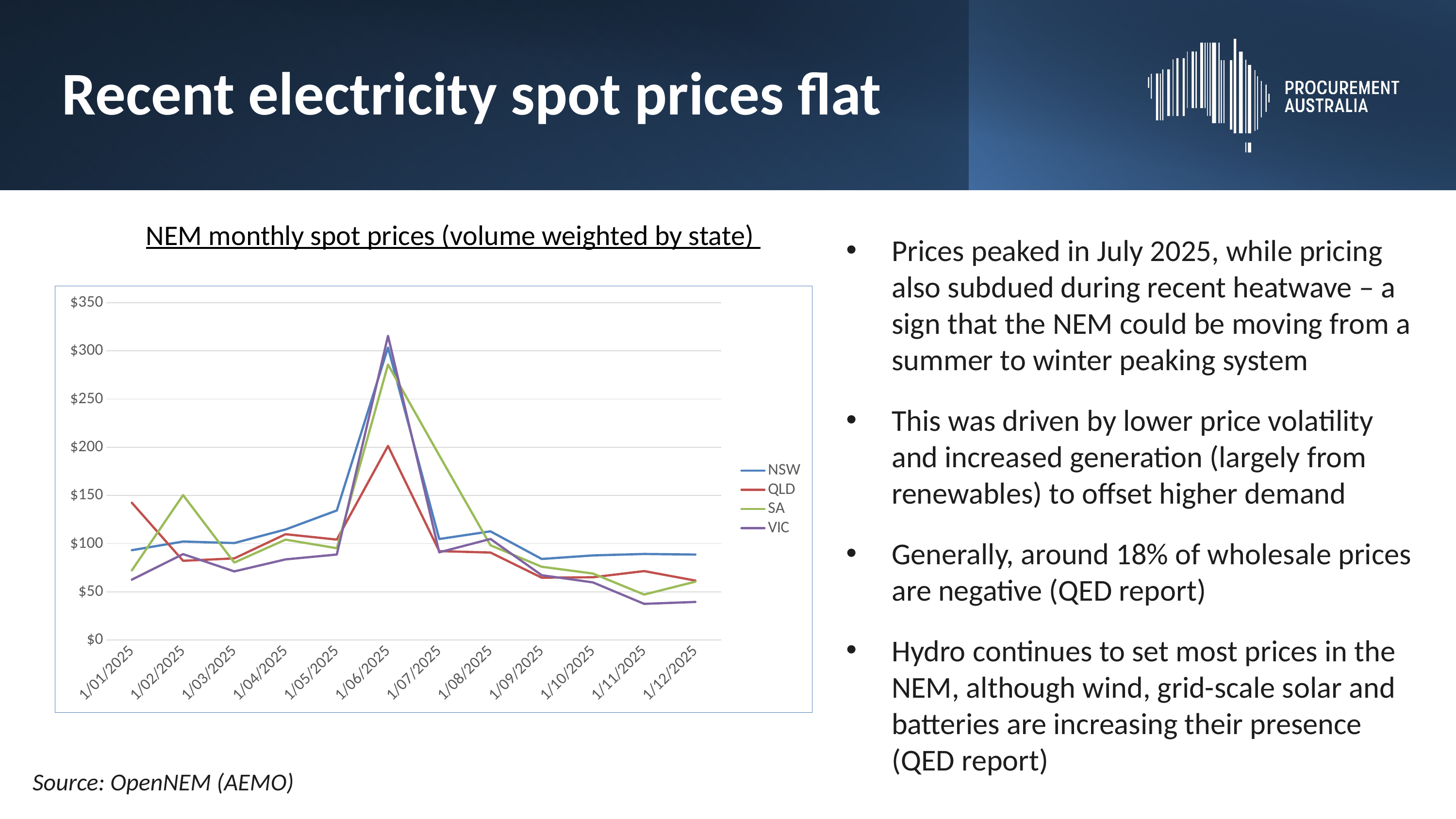
Is the value for NSW at 1/06/2025 greater or less than $250? greater In which month does the NSW series reach its highest value? 1/06/2025 How many series does the chart legend list? 4 Is the value for VIC at 1/11/2025 greater or less than $50? less Which series has the highest value at 1/01/2025? QLD What kind of chart is shown on the slide? line chart How many monthly points are plotted along the x axis? 12 Do the NSW values rise or fall from 1/06/2025 to 1/09/2025? fall Is the value for QLD at 1/01/2025 greater or less than $100? greater Which series has the lowest value at 1/12/2025? VIC What is the title of the chart? NEM monthly spot prices (volume weighted by state) At 1/06/2025, which is larger: the VIC value or the QLD value? VIC